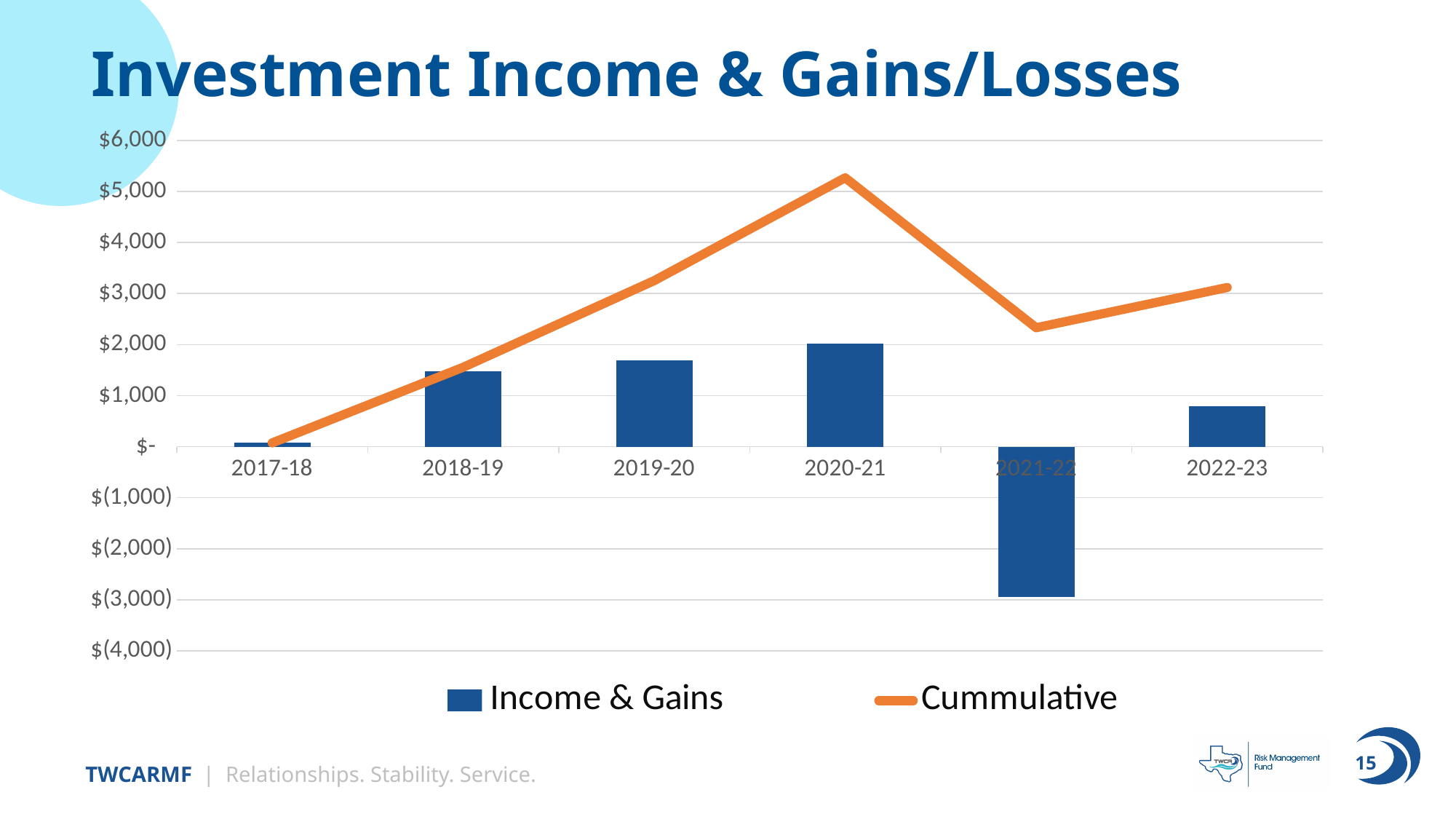
What colour is the Cummulative line? Orange Which year has the highest Income & Gains bar? 2020-21 Is the Income & Gains value for 2019-20 greater or less than $2,000? less How many fiscal years are shown on the x axis? 6 In which year does the Cummulative line reach its peak? 2020-21 How many series does the legend list? 2 Is the Cummulative value for 2020-21 greater or less than $5,000? greater Does the Cummulative line rise or fall from 2017-18 to 2020-21? It rises Is the Cummulative value for 2021-22 greater or less than $3,000? less What kind of chart is shown on the slide? A combination bar and line chart Which year has the larger Income & Gains bar, 2018-19 or 2019-20? 2019-20 Which year has the lowest Income & Gains bar? 2021-22